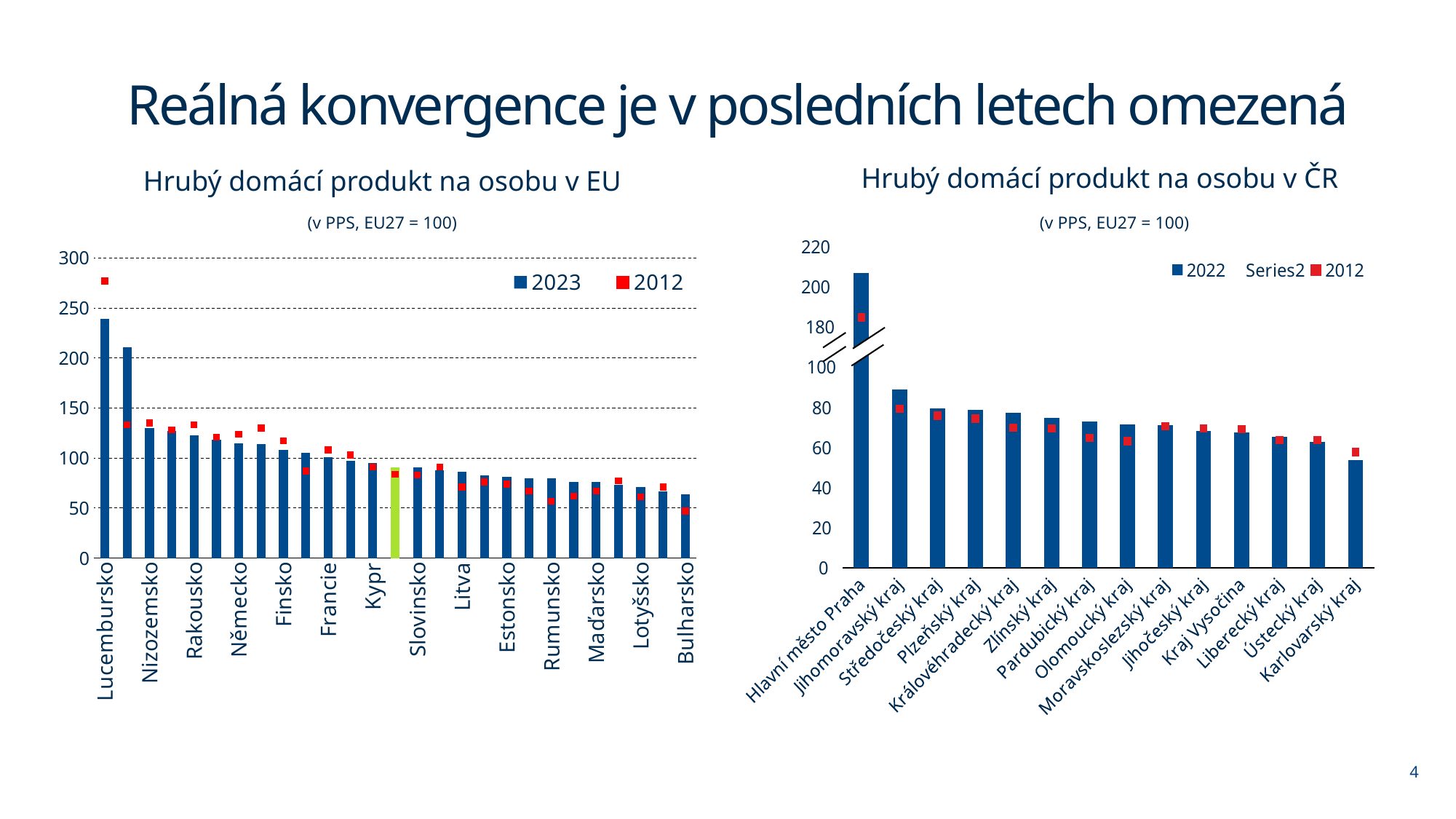
On the chart 'Hrubý domácí produkt na osobu v EU', is the 2023 value for Lucembursko greater or less than 200? greater On the chart 'Hrubý domácí produkt na osobu v ČR', how many entries does the legend list? 3 On the chart 'Hrubý domácí produkt na osobu v ČR', which region has the lowest 2022 bar? Karlovarský kraj On the chart 'Hrubý domácí produkt na osobu v EU', which labelled country has the lowest 2023 bar? Bulharsko On the chart 'Hrubý domácí produkt na osobu v EU', is the 2023 value for Bulharsko greater or less than 100? less On the chart 'Hrubý domácí produkt na osobu v ČR', how many regions are shown on the x axis? 14 On the chart 'Hrubý domácí produkt na osobu v EU', how many series does the legend list? 2 On the chart 'Hrubý domácí produkt na osobu v ČR', is the 2022 value for Jihomoravský kraj greater or less than 80? greater On the chart 'Hrubý domácí produkt na osobu v EU', which labelled country has the highest 2023 bar? Lucembursko On the chart 'Hrubý domácí produkt na osobu v EU', which has the larger 2023 bar, Lucembursko or Nizozemsko? Lucembursko On the chart 'Hrubý domácí produkt na osobu v ČR', which region has the highest 2022 bar? Hlavní město Praha